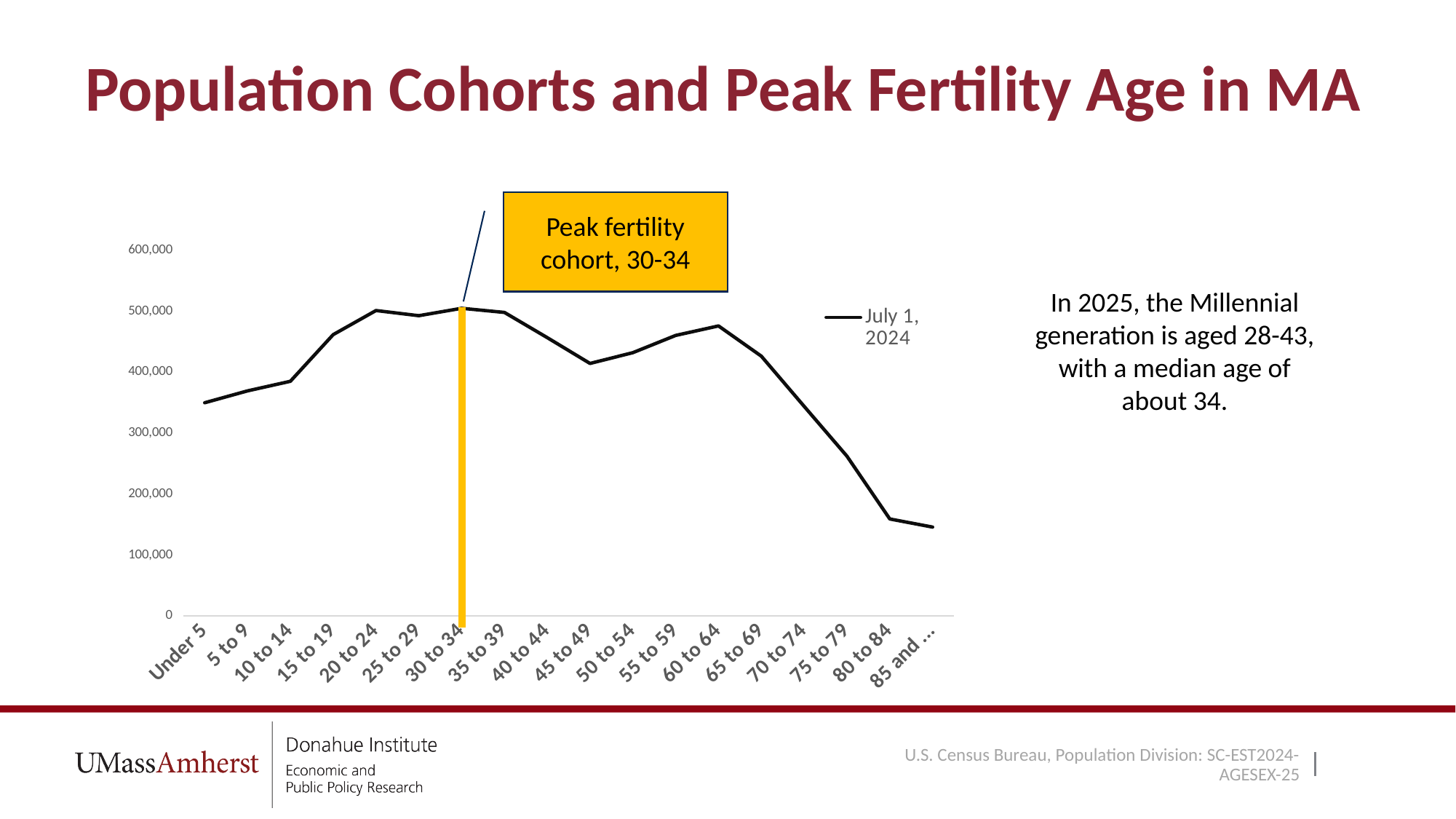
Which age cohort does the yellow callout label as the peak fertility cohort? 30-34 Do the values rise or fall along the x axis from 60 to 64 through 85 and over? fall Is the value for 70 to 74 greater or less than 300,000? greater Is the value for Under 5 greater or less than 400,000? less Which age category has the lowest value on the chart? 85 and over What kind of chart is shown on the slide? line chart What is the name of the series shown in the chart legend? July 1, 2024 How many series does the chart legend list? 1 Which has the larger value, 15 to 19 or Under 5? 15 to 19 Is the value for 60 to 64 greater or less than 400,000? greater How many age categories are plotted along the x axis? 18